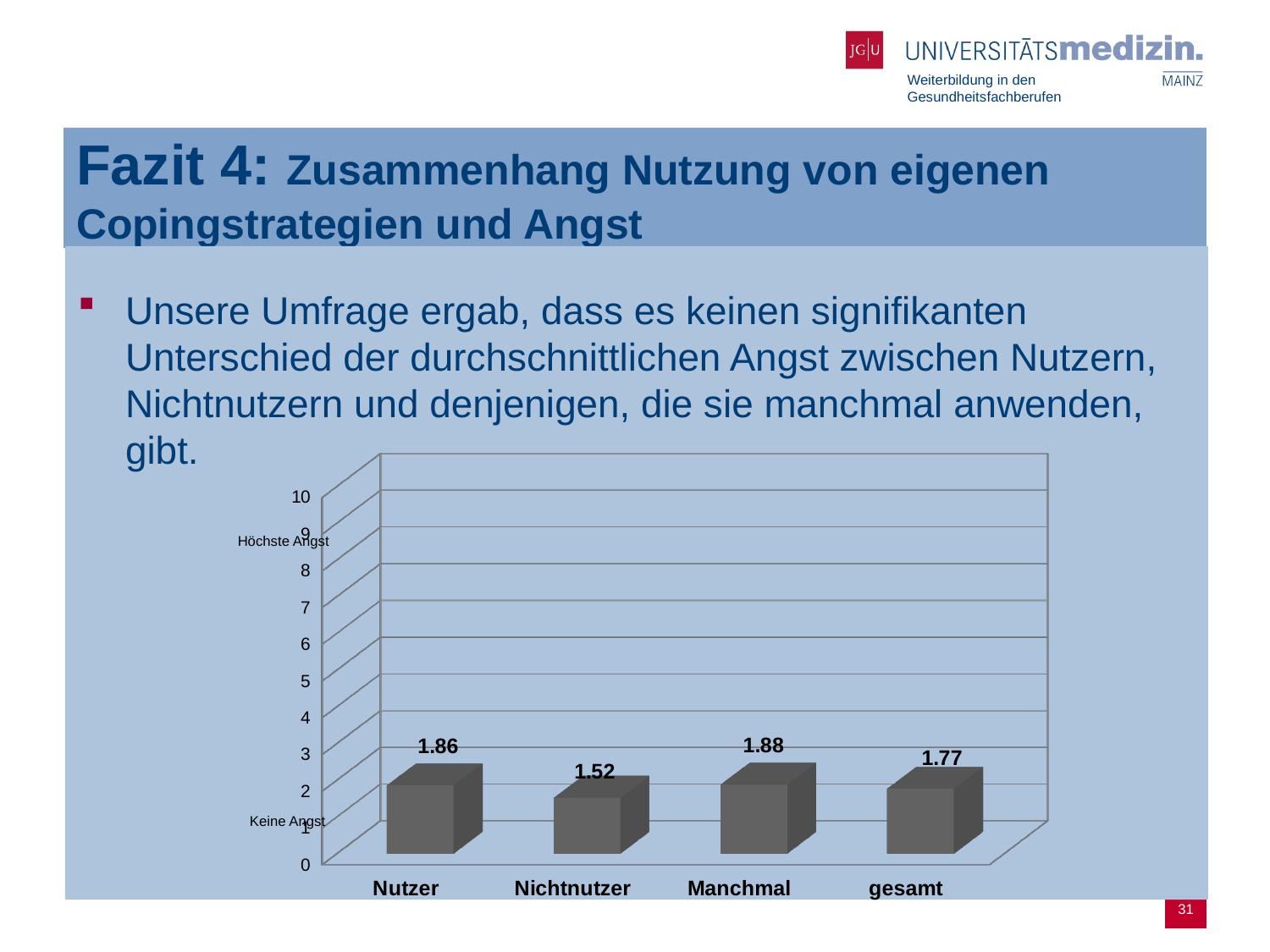
How many categories are shown on the x axis? 4 What is the value for Manchmal? 1.88 Which is larger, the value for Nutzer or the value for Nichtnutzer? Nutzer What is the value for Nutzer? 1.86 What is the value for Nichtnutzer? 1.52 Is the value for Manchmal greater or less than 5? less What is the value for gesamt? 1.77 What is the difference between the values for Manchmal and gesamt? 0.11 What kind of chart is shown on the slide? bar chart What is the difference between the values for Nutzer and Nichtnutzer? 0.34 Which category has the lowest value? Nichtnutzer What text label appears near the top of the y axis? Höchste Angst